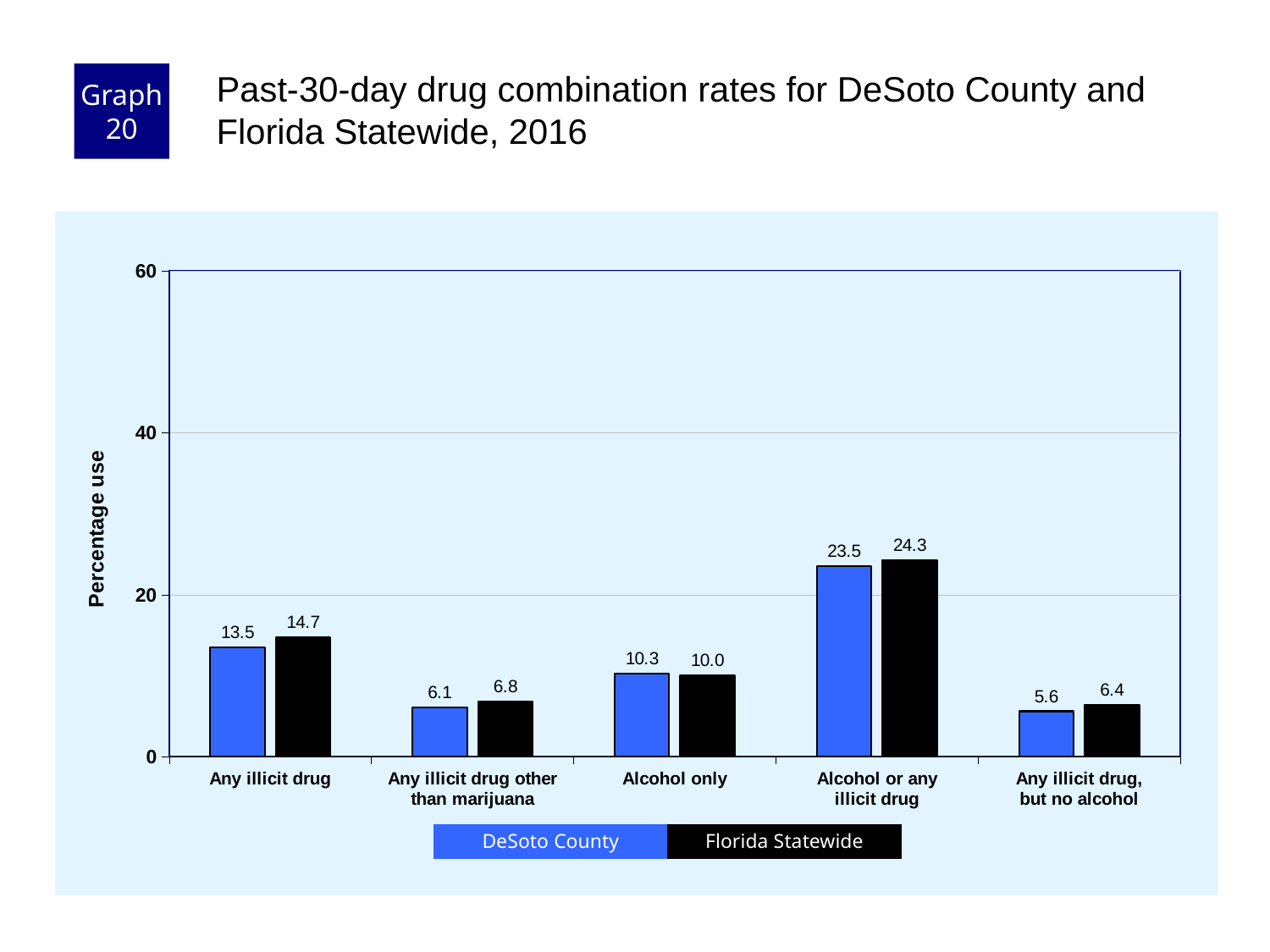
Which category has the highest DeSoto County value? Alcohol or any illicit drug What kind of chart is shown on the slide? bar chart Which category has the lowest Florida Statewide value? Any illicit drug, but no alcohol What is the DeSoto County value for Any illicit drug, but no alcohol? 5.6 What is the difference between the Florida Statewide and DeSoto County values for Any illicit drug? 1.2 How many series does the legend list? 2 What is the difference between the DeSoto County and Florida Statewide values for Alcohol only? 0.3 How many categories are shown on the x axis? 5 Is the Florida Statewide value for Alcohol or any illicit drug greater or less than 20? greater What is the Florida Statewide value for Alcohol or any illicit drug? 24.3 Which is larger for Any illicit drug other than marijuana: DeSoto County or Florida Statewide? Florida Statewide What is the DeSoto County value for Any illicit drug? 13.5